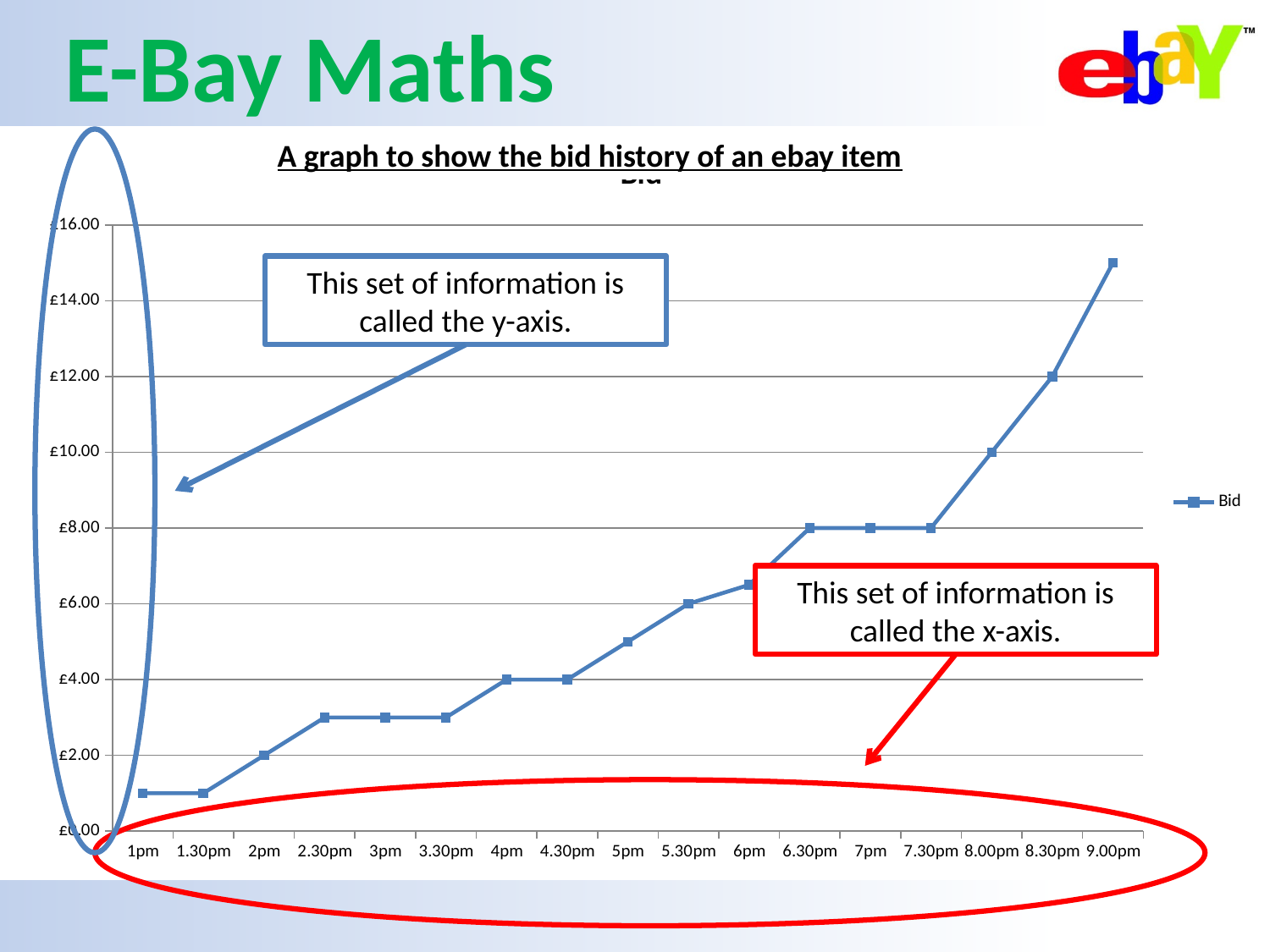
What kind of chart is shown on the slide? line chart Is the bid value at 9.00pm greater or less than £14.00? greater Do the bid values generally rise or fall from 1pm to 9.00pm? rise What is the bid value at 2pm? £2.00 Is the bid value at 3pm greater or less than £4.00? less At which time is the bid highest? 9.00pm How many series does the legend list? 1 How many time points are plotted along the x-axis? 17 What is the bid value at 6.30pm? £8.00 What is the bid value at 8.00pm? £10.00 What is the name of the series shown in the legend? Bid What is the bid value at 8.30pm? £12.00